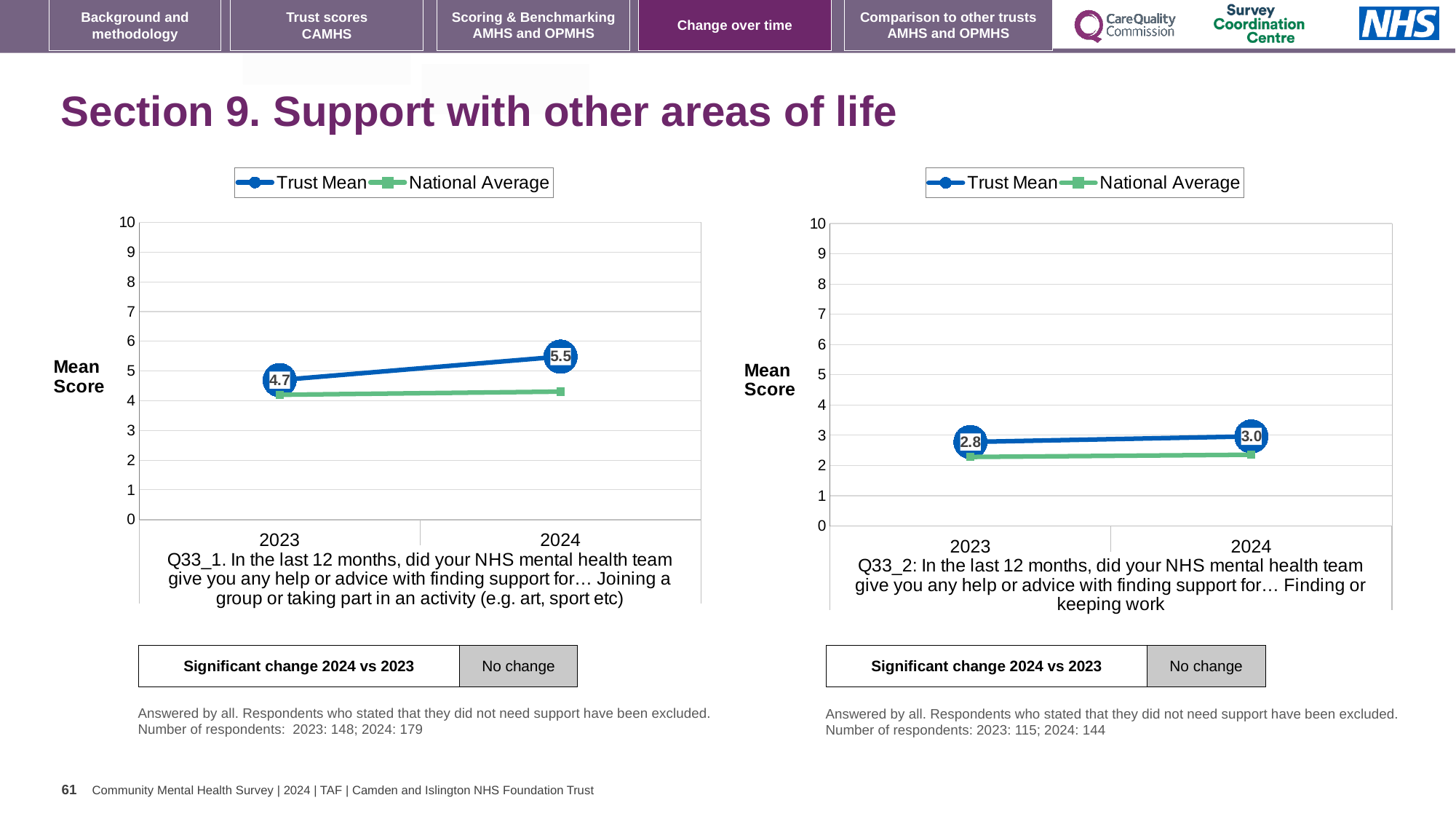
In the left chart (Q33_1), by how much did the Trust Mean change from 2023 to 2024? 0.8 In the right chart (Q33_2), what is the Trust Mean value for 2023? 2.8 In the right chart (Q33_2), is the National Average value for 2023 greater or less than 3? less What kind of chart is the right chart (Q33_2)? line chart In the right chart (Q33_2), what is the difference between the Trust Mean in 2024 and in 2023? 0.2 In the left chart (Q33_1), what is the Trust Mean value for 2023? 4.7 In the left chart (Q33_1), does the Trust Mean rise or fall from 2023 to 2024? rise How many series does the legend of the left chart (Q33_1) list? 2 In the left chart (Q33_1), is the Trust Mean in 2024 higher or lower than the National Average in 2024? higher In the left chart (Q33_1), what is the Trust Mean value for 2024? 5.5 In the right chart (Q33_2), what is the Trust Mean value for 2024? 3.0 How many years are plotted on the x axis of the left chart (Q33_1)? 2